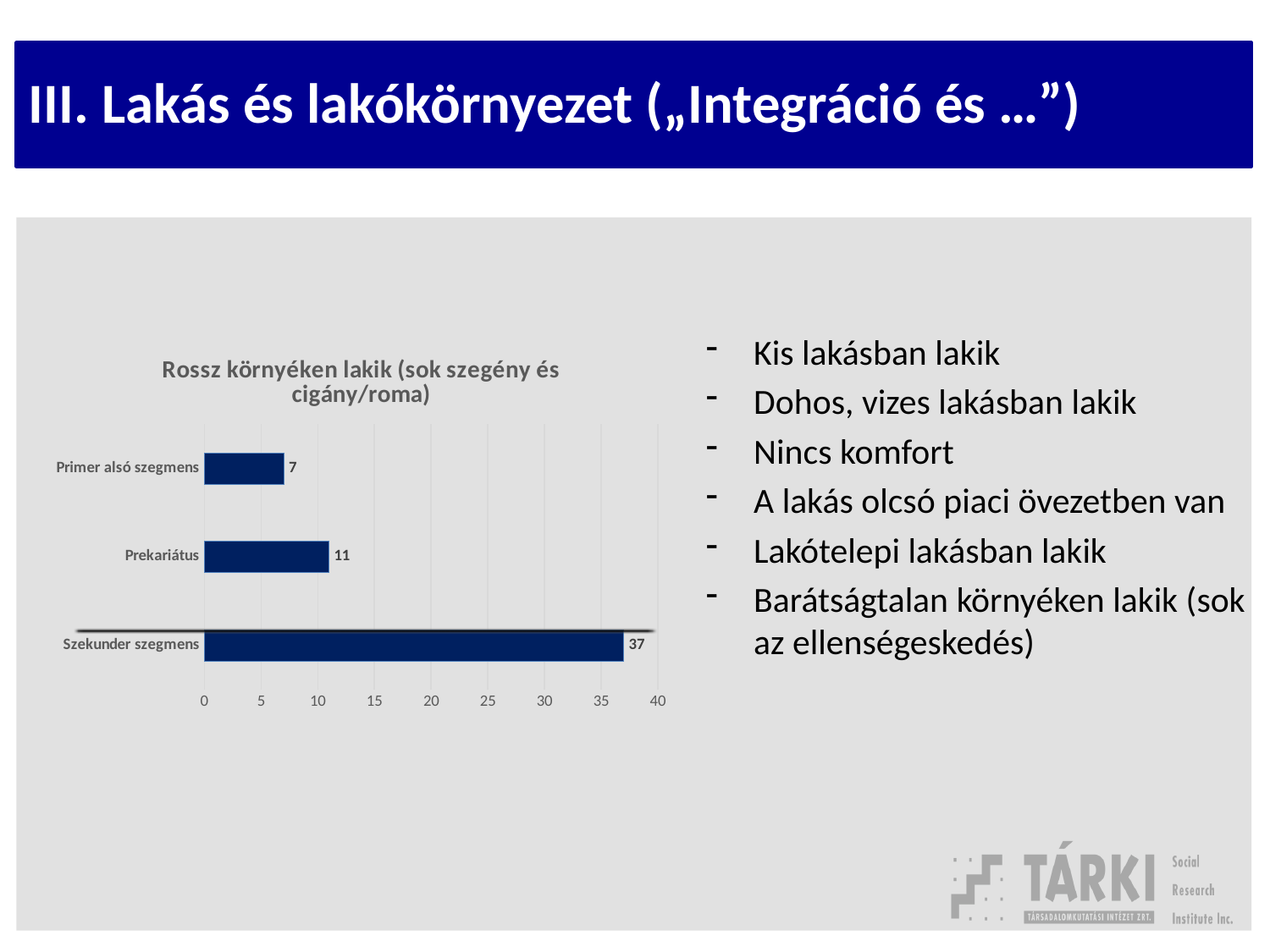
How many categories are shown in the chart? 3 Which category has the highest value? Szekunder szegmens Which category has the lowest value? Primer alsó szegmens What kind of chart is shown on the slide? Bar chart What is the value for Szekunder szegmens? 37 What is the title of the chart? Rossz környéken lakik (sok szegény és cigány/roma) What is the value for Prekariátus? 11 What is the difference between the values for Prekariátus and Primer alsó szegmens? 4 What is the value for Primer alsó szegmens? 7 Is the value for Szekunder szegmens greater or less than 35? greater Which is larger, the value for Prekariátus or the value for Primer alsó szegmens? Prekariátus What is the difference between the values for Szekunder szegmens and Prekariátus? 26